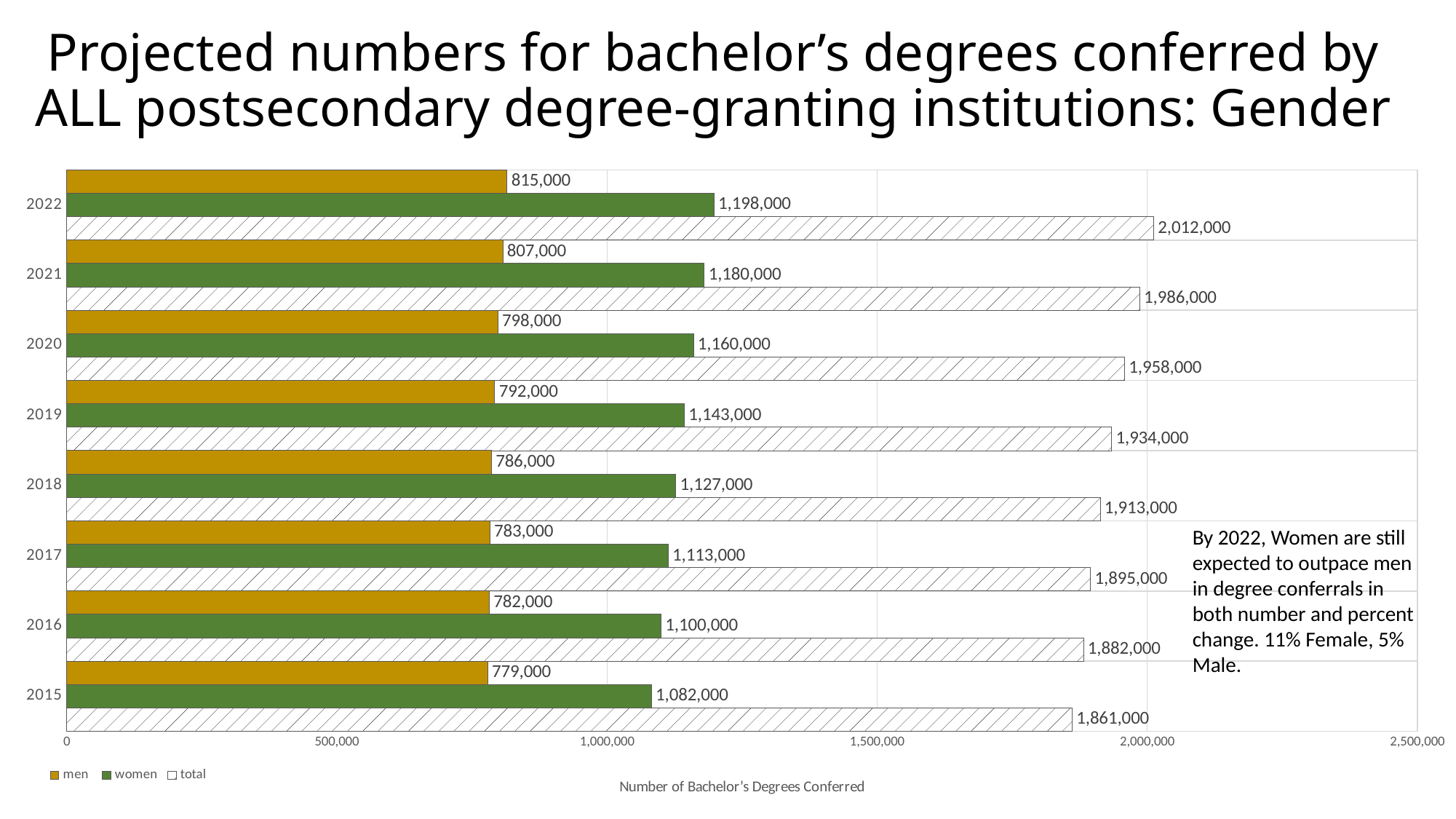
What is the projected total number of bachelor's degrees conferred in 2019? 1,934,000 What is the projected number of bachelor's degrees conferred to women in 2022? 1,198,000 Which is larger in 2018: the projected number of degrees conferred to men or to women? women Do the projected totals rise or fall from 2015 to 2022? rise What kind of chart is shown on the slide? bar chart Is the projected total for 2022 greater or less than 2,000,000? greater What is the difference between the projected number of degrees conferred to women and to men in 2022? 383,000 Which year has the lowest projected number of bachelor's degrees conferred to women? 2015 Which year has the highest projected total of bachelor's degrees conferred? 2022 How many series does the legend list? 3 How many years are shown on the chart? 8 What is the projected number of bachelor's degrees conferred to men in 2015? 779,000